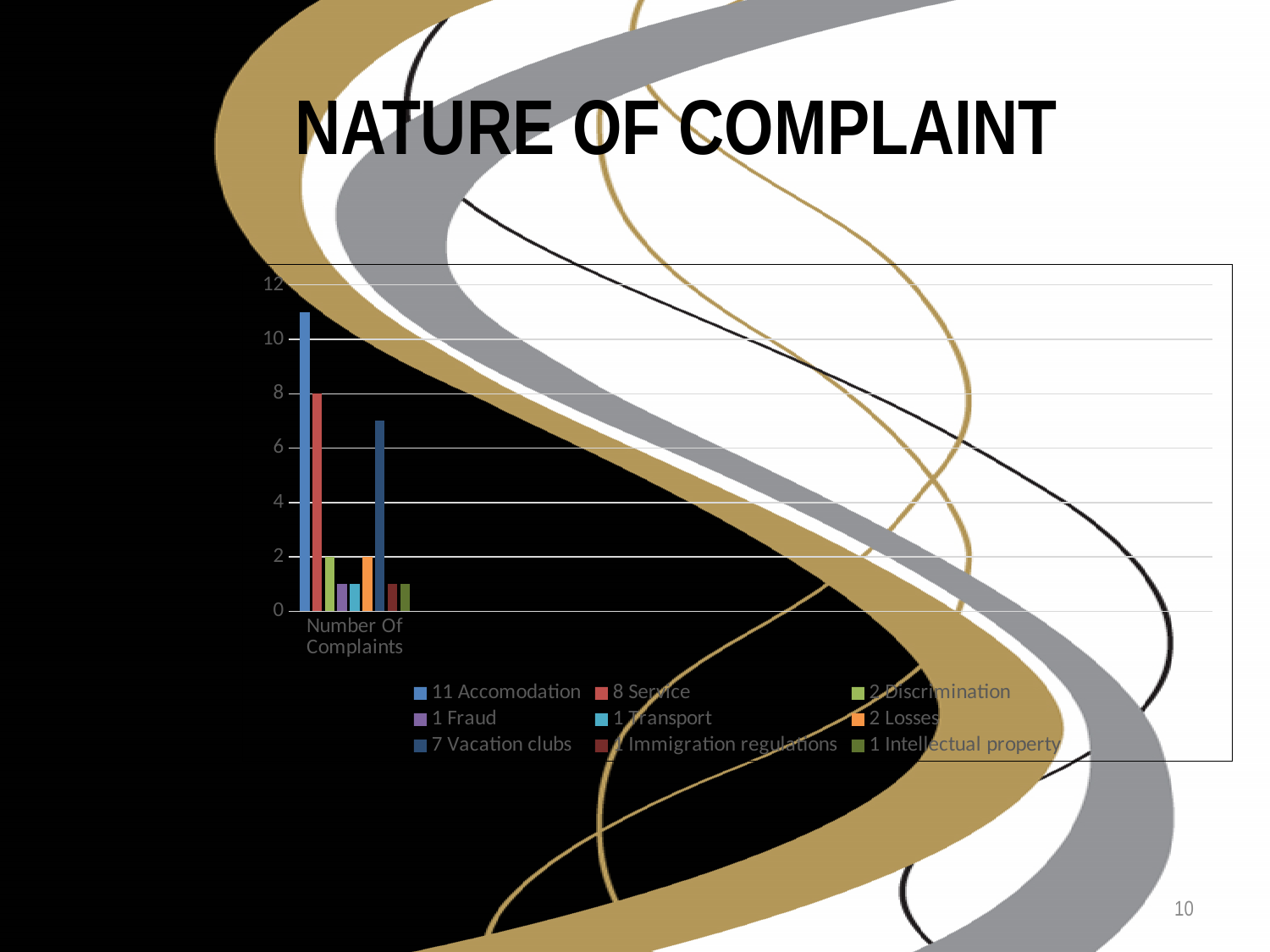
How many complaints are shown for Vacation clubs? 7 Is the value for Accomodation greater or less than 10? greater What type of chart is shown on the slide? bar chart How many complaints are shown for Service? 8 Which has more complaints, Service or Vacation clubs? Service How many complaints are shown for Accomodation? 11 What is the difference between the number of Vacation clubs complaints and Losses complaints? 5 How many series does the chart legend list? 9 What is the difference between the number of Accomodation complaints and Service complaints? 3 What is the title of the slide containing the chart? NATURE OF COMPLAINT What is the category label shown on the x axis of the chart? Number Of Complaints Which complaint type has the highest number of complaints? Accomodation